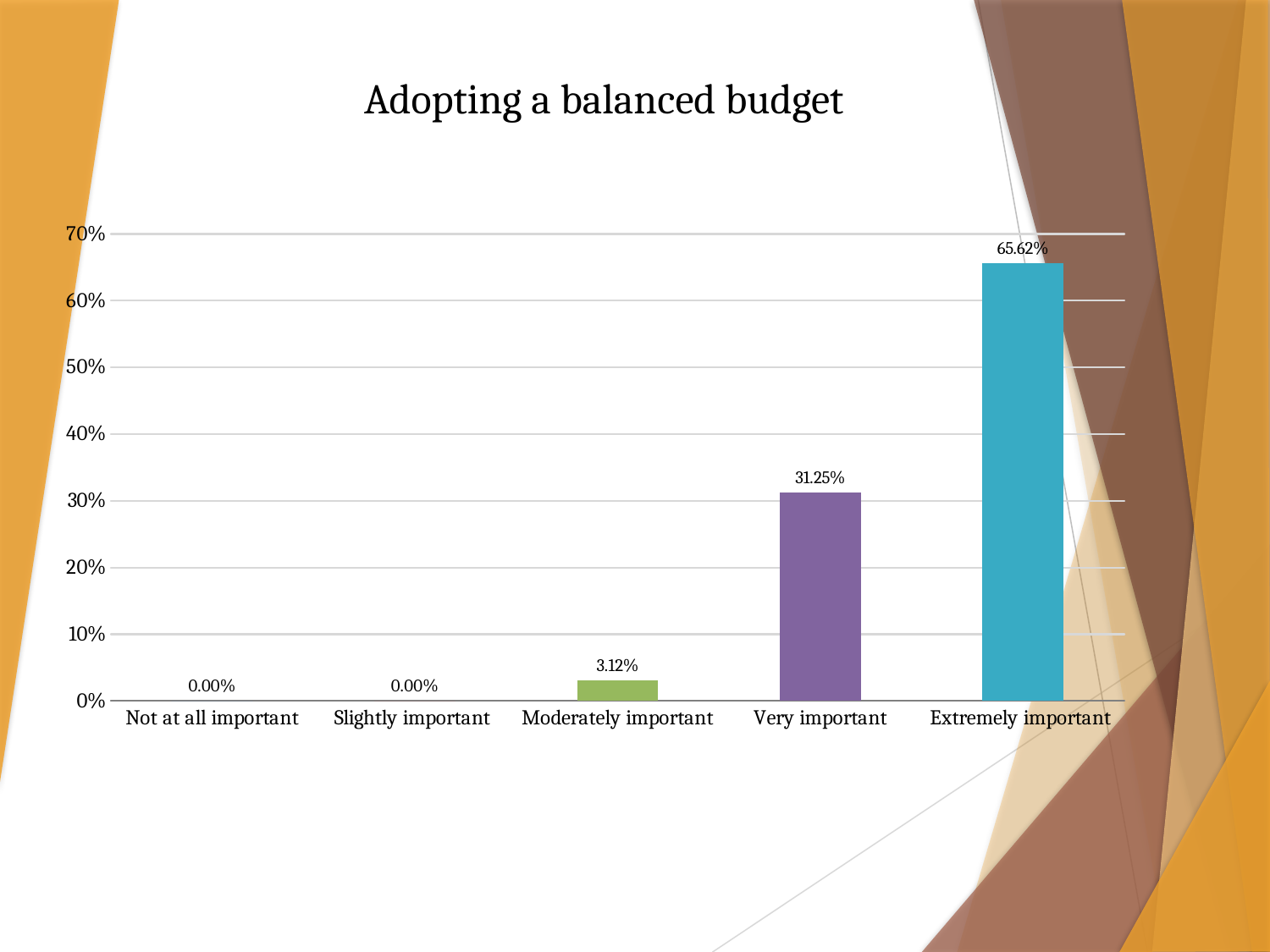
What is the title of the chart? Adopting a balanced budget What kind of chart is shown on the slide? Bar chart What is the value for Very important? 31.25% Is the value for Extremely important greater or less than 60%? greater Do the values rise or fall moving from Not at all important to Extremely important along the x axis? Rise Which category has the highest value? Extremely important What is the value for Moderately important? 3.12% What is the value for Not at all important? 0.00% What is the difference between the values for Extremely important and Very important? 34.37% What is the value for Extremely important? 65.62% Which is larger, the value for Very important or the value for Moderately important? Very important How many categories are shown on the x axis? 5